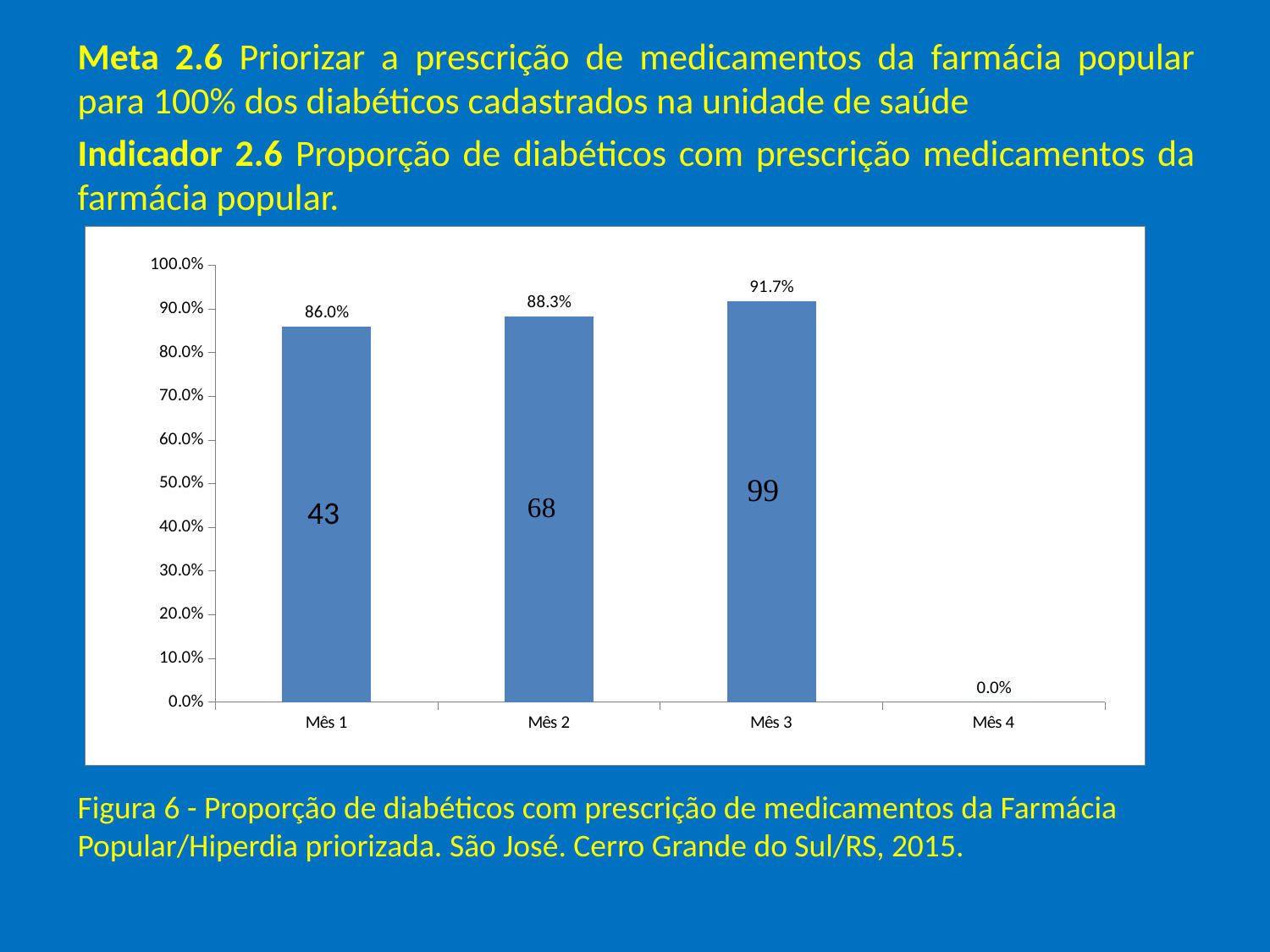
What number is printed inside the bar for Mês 3? 99 What kind of chart is shown on the slide? Bar chart What is the value for Mês 2? 88.3% What is the value for Mês 1? 86.0% How many months are shown on the x axis? 4 What is the difference between the percentages for Mês 3 and Mês 1? 5.7% What is the value for Mês 4? 0.0% Do the values rise or fall from Mês 1 to Mês 3? Rise Which month has the highest percentage? Mês 3 Which is larger, the value for Mês 2 or the value for Mês 1? Mês 2 Which month has the lowest percentage? Mês 4 What is the value for Mês 3? 91.7%